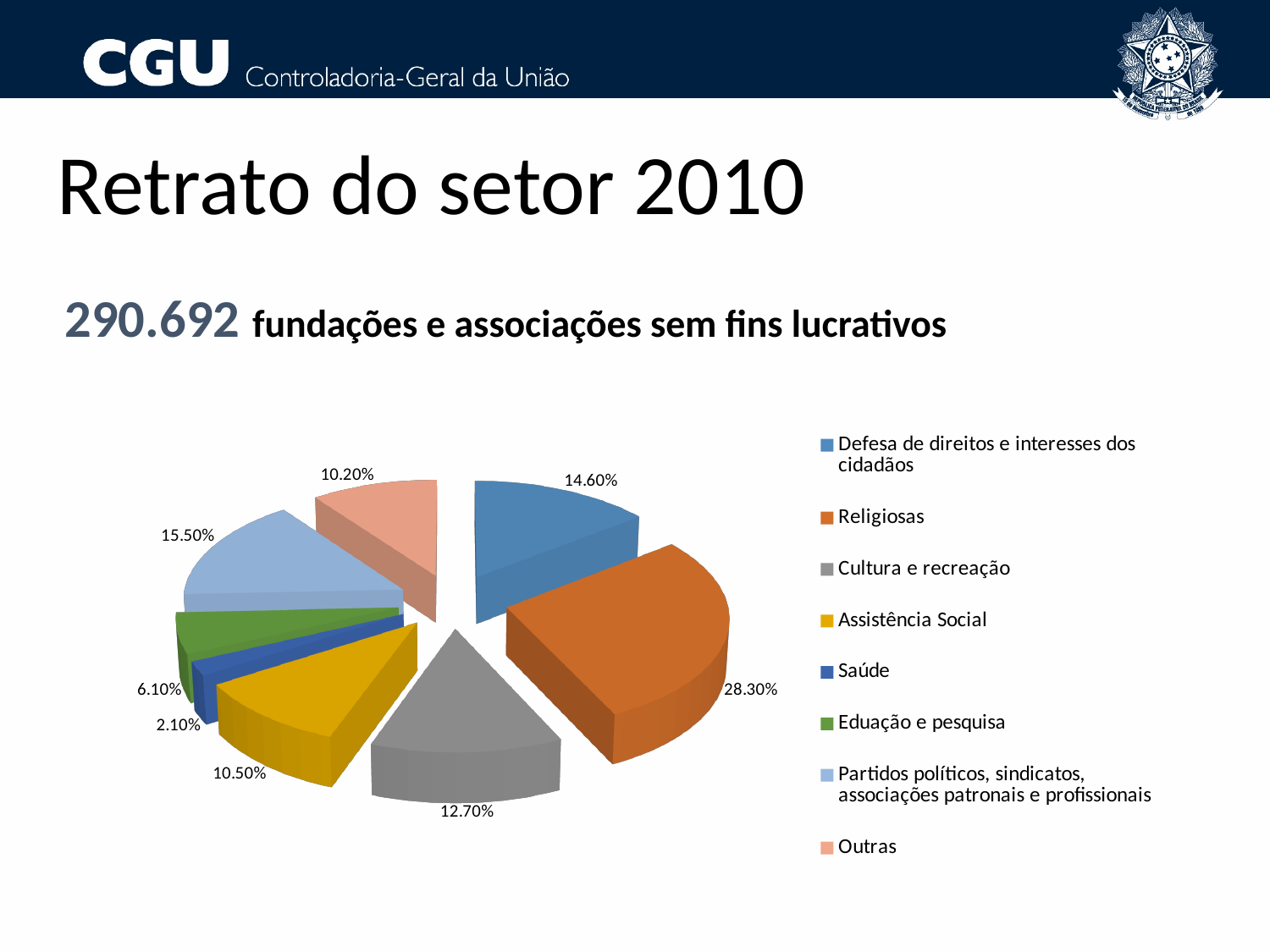
How many slices does the pie chart have? 8 Which category has the smallest share of the pie? Saúde What colour is the slice for Assistência Social? Yellow Which category has the largest share of the pie? Religiosas What kind of chart is shown on the slide? Pie chart What is the difference between the shares of Religiosas and Assistência Social? 17.80% Which has a larger share, Eduação e pesquisa or Outras? Outras What percentage is shown for Partidos políticos, sindicatos, associações patronais e profissionais? 15.50% What percentage is shown for Religiosas? 28.30% What percentage is shown for Defesa de direitos e interesses dos cidadãos? 14.60% What percentage is shown for Cultura e recreação? 12.70% What percentage is shown for Saúde? 2.10%